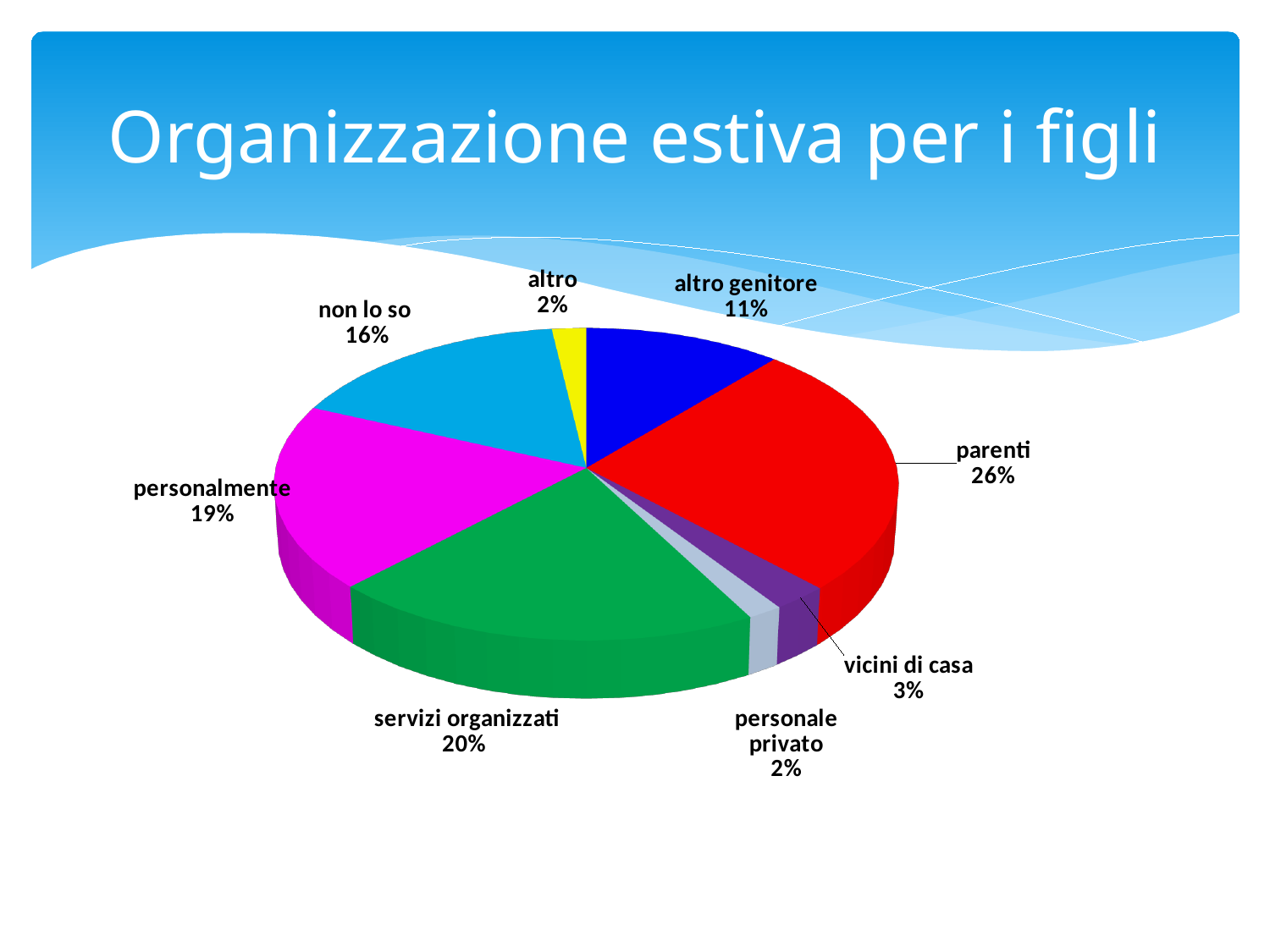
What share of the pie does 'parenti' represent? 26% What is the value shown for 'servizi organizzati'? 20% What is the value shown for 'vicini di casa'? 3% What is the difference between 'parenti' and 'personalmente'? 7% What is the title of the slide? Organizzazione estiva per i figli What kind of chart is shown on the slide? pie chart How many categories are shown in the pie chart? 8 Which category has the largest slice of the pie? parenti What percentage is shown for 'non lo so'? 16% What is the difference between 'non lo so' and 'altro genitore'? 5% What colour is the 'parenti' slice? red Which is larger, 'servizi organizzati' or 'altro genitore'? servizi organizzati